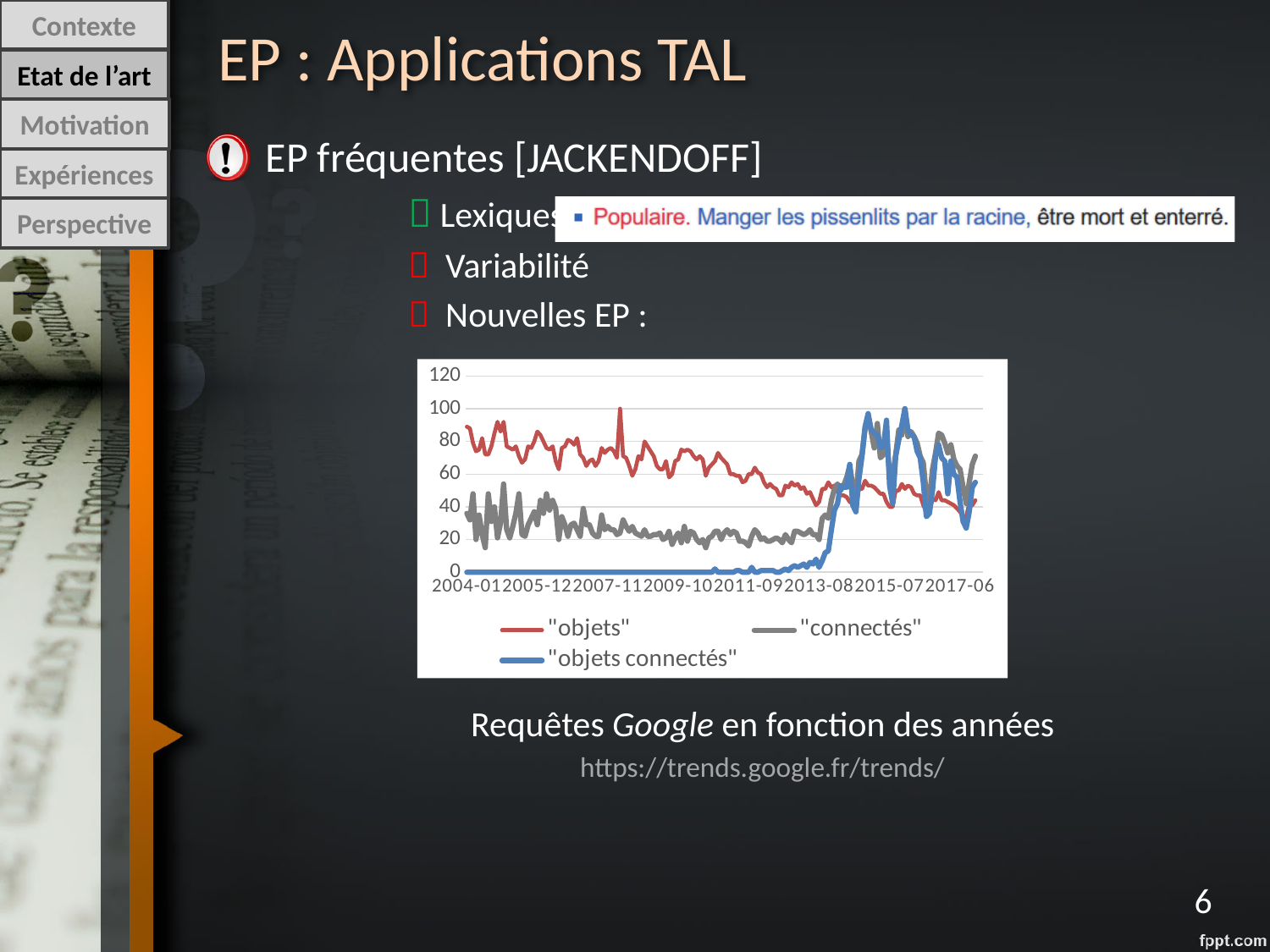
Is the value for "objets" at 2004-01 greater or less than 80? greater Is the value for "objets connectés" at 2004-01 greater or less than 20? less How many date labels are shown on the x axis of the chart? 8 At 2004-01, which series has the higher value, "objets" or "objets connectés"? "objets" What colour is the line for "objets connectés"? blue Does the "objets connectés" series generally rise or fall from 2004-01 to 2017-06? rise Around 2015-07, which series has the higher value, "objets connectés" or "objets"? "objets connectés" Is the value for "connectés" around 2009-10 greater or less than 40? less Does the "objets" series generally rise or fall from 2004-01 to 2017-06? fall What kind of chart is shown on the slide? line chart How many series does the chart legend list? 3 Which series are listed in the chart legend? "objets", "connectés", "objets connectés"